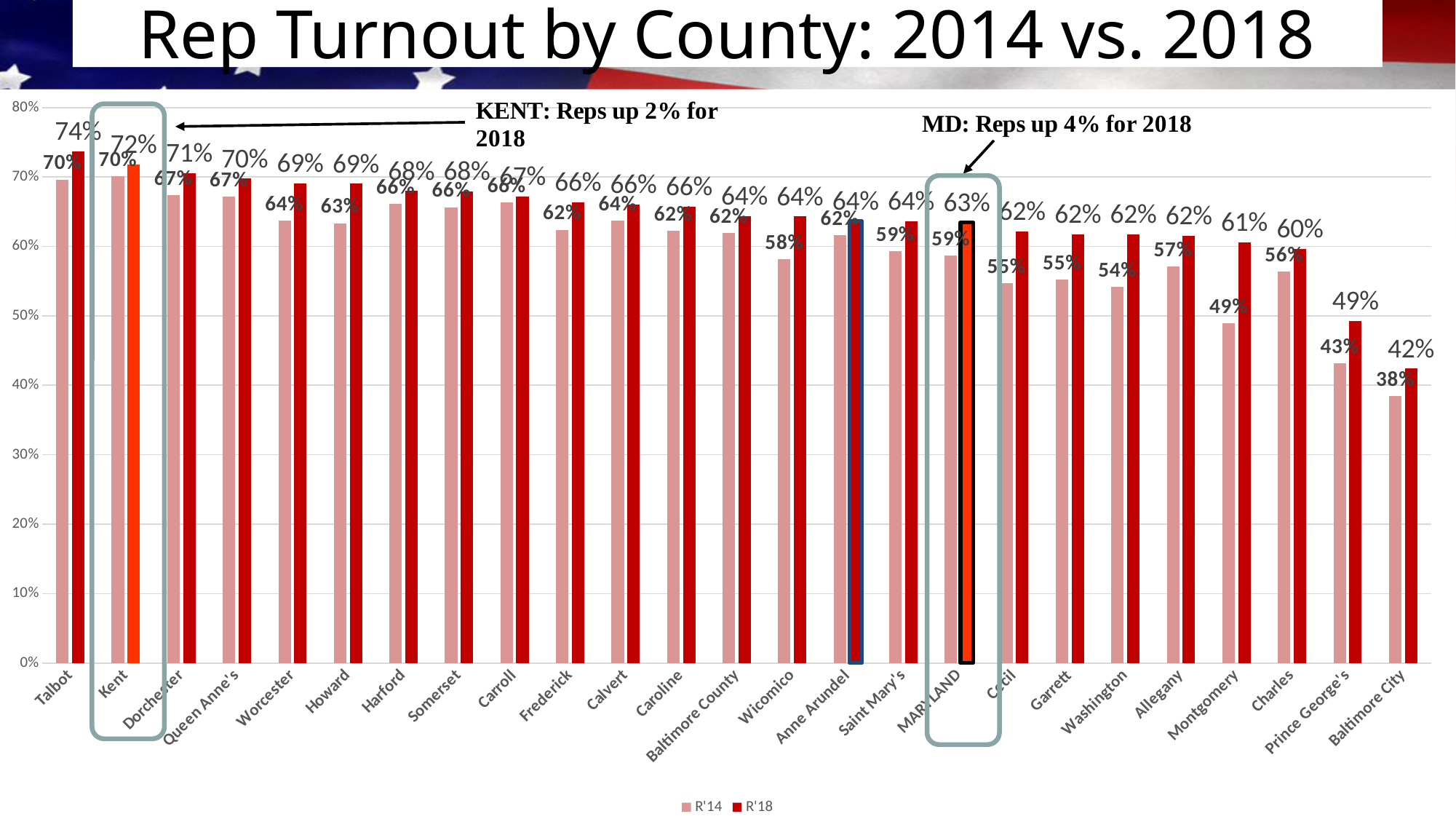
How many categories are shown on the x axis? 25 What is the R'18 value for Talbot? 74% Is the R'18 value for Baltimore City greater or less than 50%? less What is the R'18 value for MARYLAND? 63% What is the R'14 value for Baltimore City? 38% What is the R'14 value for Montgomery? 49% Which is larger, the R'14 value for Charles or the R'14 value for Prince George's? Charles How many series does the legend list? 2 What is the difference between the R'18 and R'14 values for Wicomico? 6% What kind of chart is shown on the slide? bar chart Which category has the lowest R'14 value? Baltimore City Which county has the highest R'18 value? Talbot